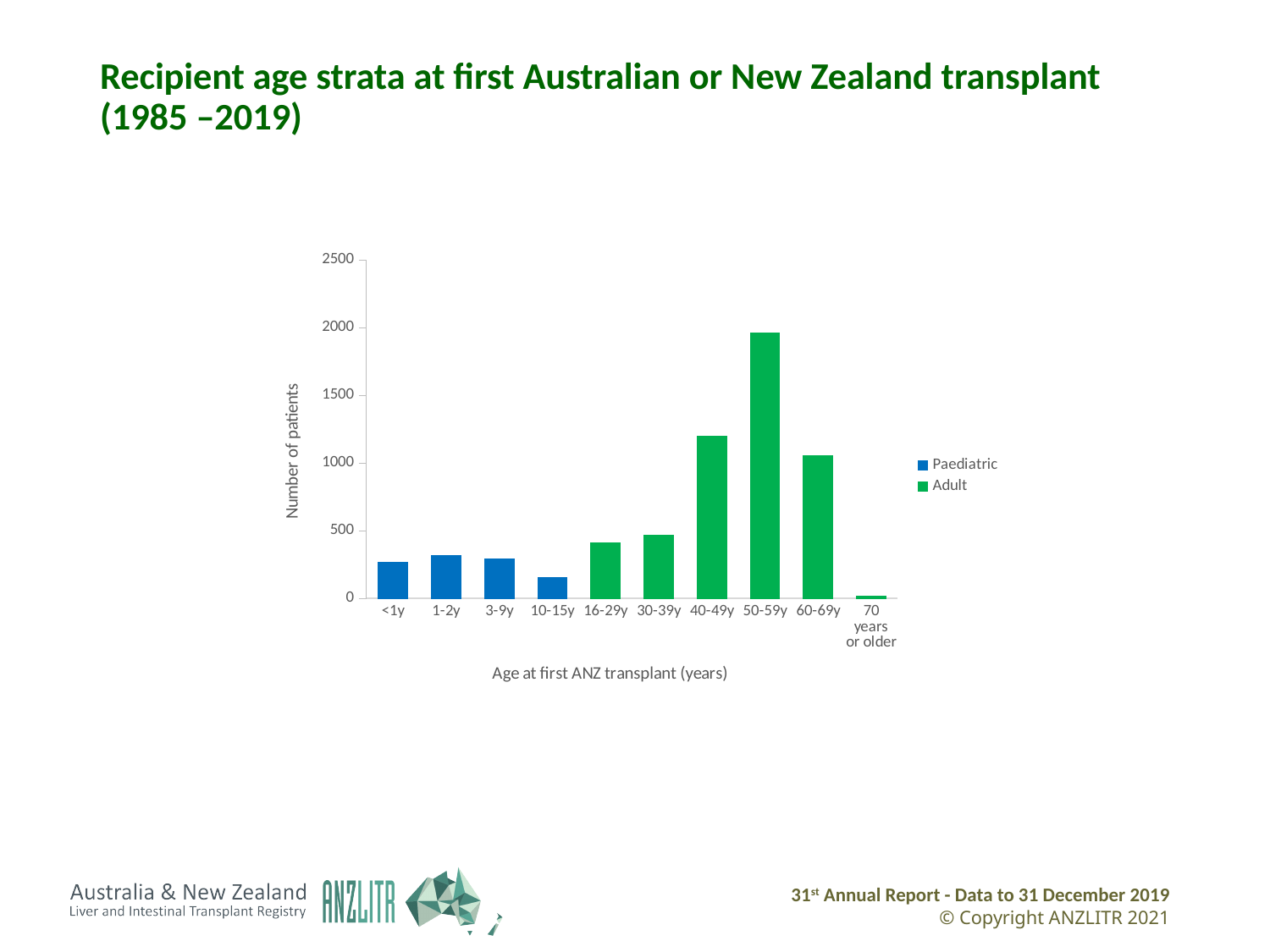
Which age group has the lowest number of patients? 70 years or older Is the number of patients for 50-59y greater or less than 1500? greater Which has more patients, the <1y group or the 10-15y group? <1y Is the number of patients for 30-39y greater or less than 500? less Is the number of patients for 10-15y greater or less than 500? less Which series is shown in green in the legend? Adult Which age group has the highest number of patients? 50-59y How many series does the legend list? 2 What kind of chart is shown on the slide? bar chart Which has more patients, the 40-49y group or the 60-69y group? 40-49y How many age groups are shown on the x axis? 10